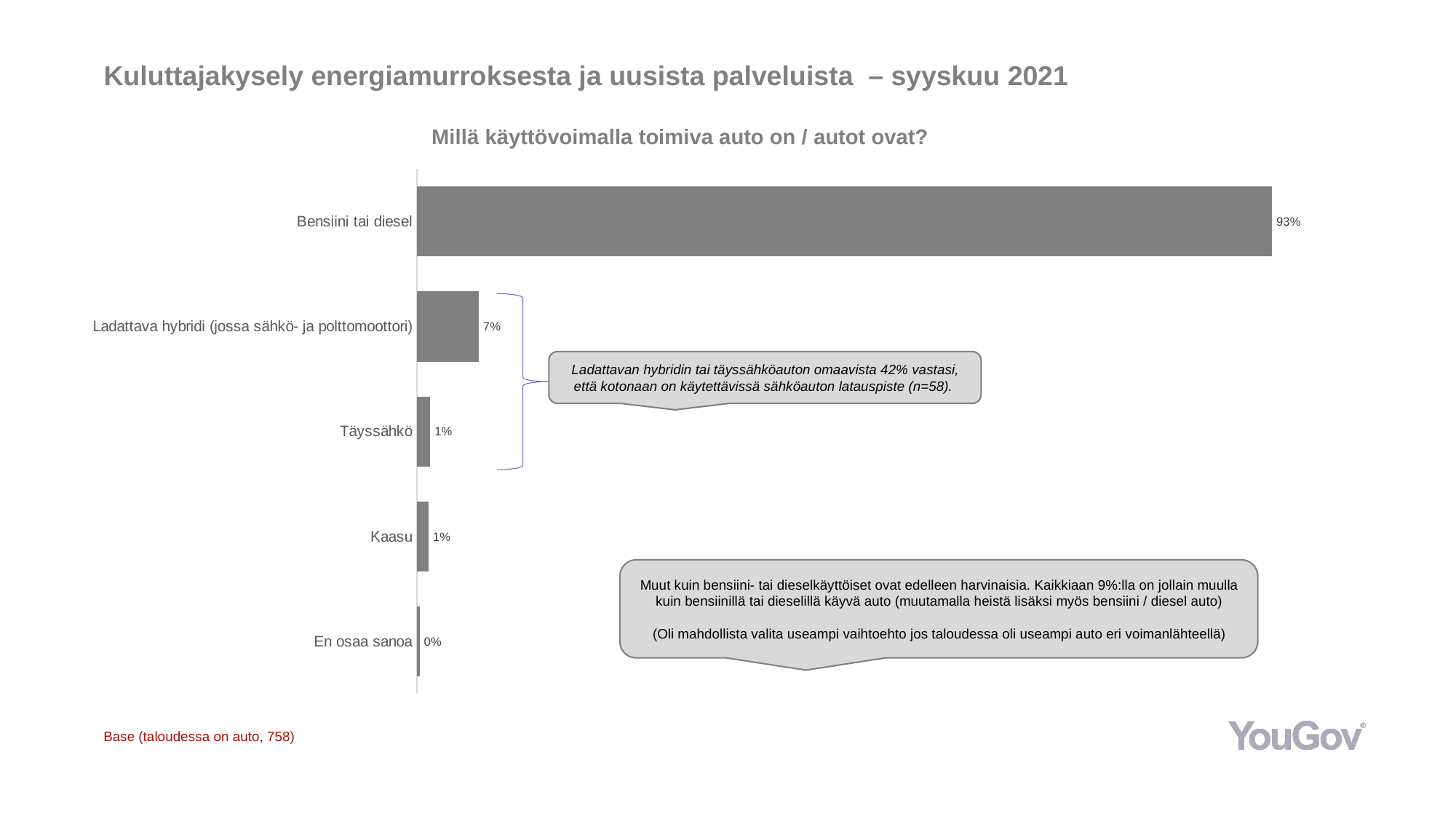
Which is larger, the value for Ladattava hybridi (jossa sähkö- ja polttomoottori) or the value for Kaasu? Ladattava hybridi (jossa sähkö- ja polttomoottori) Which category has the lowest value? En osaa sanoa What is the value for Bensiini tai diesel? 93% Which category has the highest value? Bensiini tai diesel What is the value for Täyssähkö? 1% What is the title of the chart? Millä käyttövoimalla toimiva auto on / autot ovat? What is the difference between the values for Bensiini tai diesel and Ladattava hybridi (jossa sähkö- ja polttomoottori)? 86% What is the base (number of respondents) stated on the slide? 758 What kind of chart is shown on the slide? Bar chart How many categories are shown in the chart? 5 What is the value for Ladattava hybridi (jossa sähkö- ja polttomoottori)? 7% What is the value for En osaa sanoa? 0%